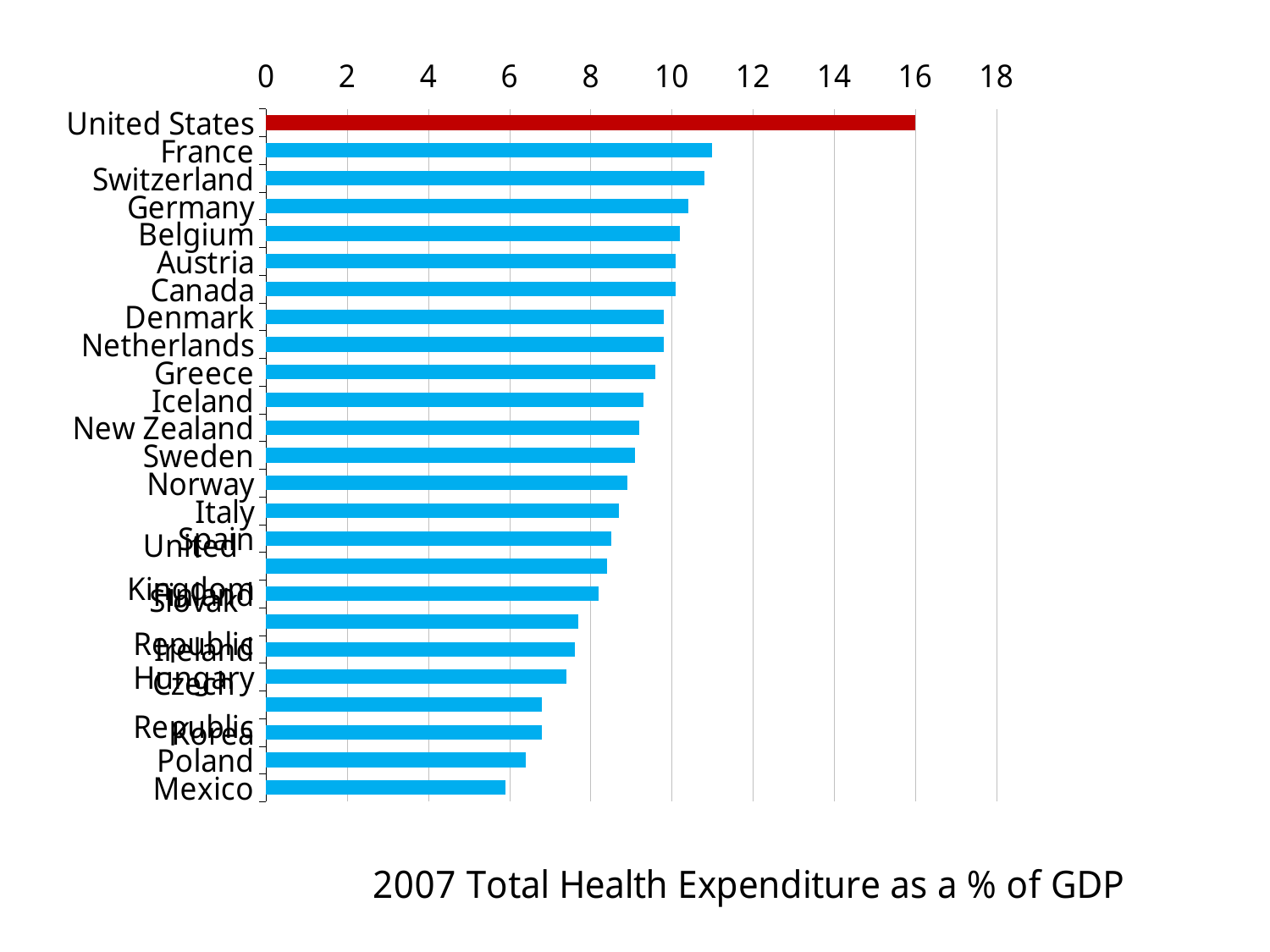
Is the value for the United States greater or less than 14? greater What is the title of the chart? 2007 Total Health Expenditure as a % of GDP Which has a higher value, Switzerland or Sweden? Switzerland Which bar is coloured differently from the others? United States Is the value for Greece greater or less than 10? less Is the value for Italy greater or less than 8? greater Which country has the lowest total health expenditure as a % of GDP? Mexico Which country has the highest total health expenditure as a % of GDP? United States What kind of chart is shown on the slide? bar chart Which has a higher value, Germany or Poland? Germany